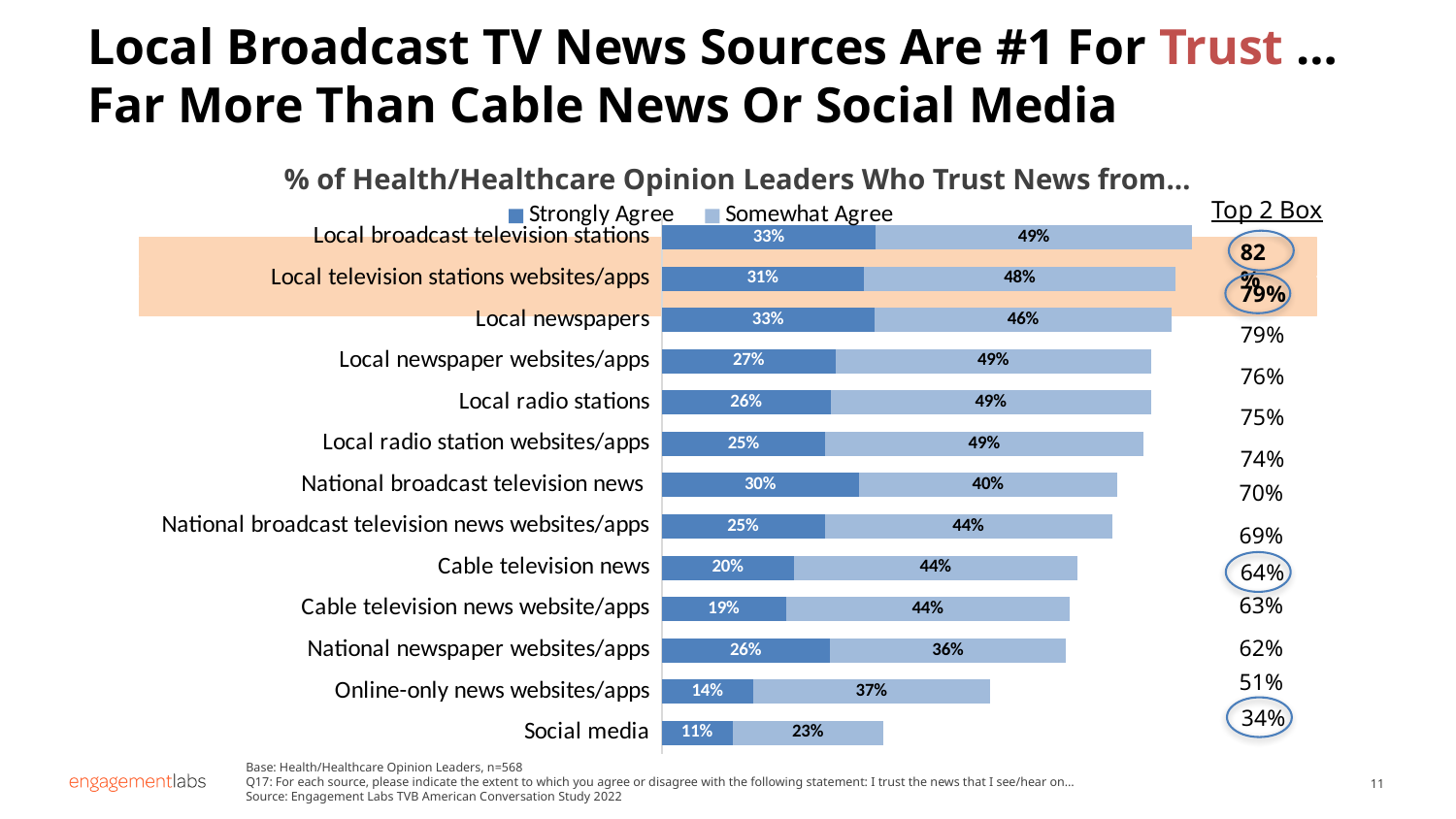
What is the Somewhat Agree value for Social media? 23% What is the total of the stacked bar for Online-only news websites/apps? 51% What is the Strongly Agree value for Local broadcast television stations? 33% Which category has the lowest Somewhat Agree value? Social media How many categories are shown in the chart? 13 What is the difference between the Strongly Agree values for Local broadcast television stations and Social media? 22% What kind of chart is shown on the slide? Stacked bar chart What is the Somewhat Agree value for National broadcast television news? 40% Which category has the lowest Strongly Agree value? Social media Which has a higher Strongly Agree value, National broadcast television news or Cable television news? National broadcast television news What is the Strongly Agree value for Cable television news? 20% How many series does the legend list? 2